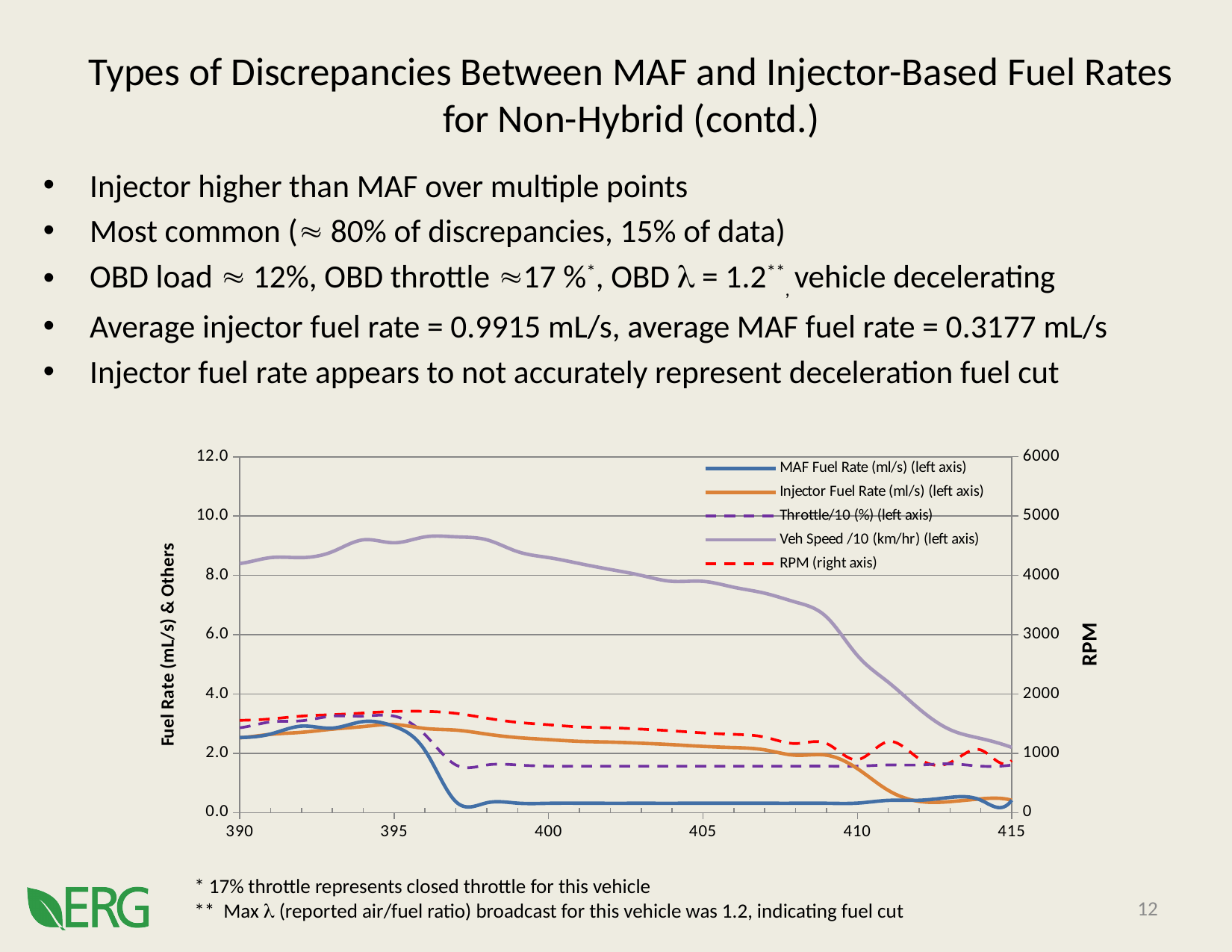
What is the title of the left vertical axis of the chart? Fuel Rate (mL/s) & Others Is the value of Veh Speed /10 (km/hr) at x = 395 greater or less than 8.0? greater What kind of chart is shown on the slide? line chart Is the value of MAF Fuel Rate (ml/s) at x = 400 greater or less than 2.0? less Does the Veh Speed /10 (km/hr) series rise or fall overall along the x axis from 390 to 415? fall Is the RPM value at x = 390 greater or less than 1000? greater Does the MAF Fuel Rate (ml/s) series rise or fall overall along the x axis from 390 to 415? fall At x = 405, which is higher: Veh Speed /10 (km/hr) or Throttle/10 (%)? Veh Speed /10 (km/hr) At x = 400, which is higher: the MAF Fuel Rate or the Injector Fuel Rate? Injector Fuel Rate Which series in the chart is plotted on the right axis? RPM (right axis) How many series does the chart legend list? 5